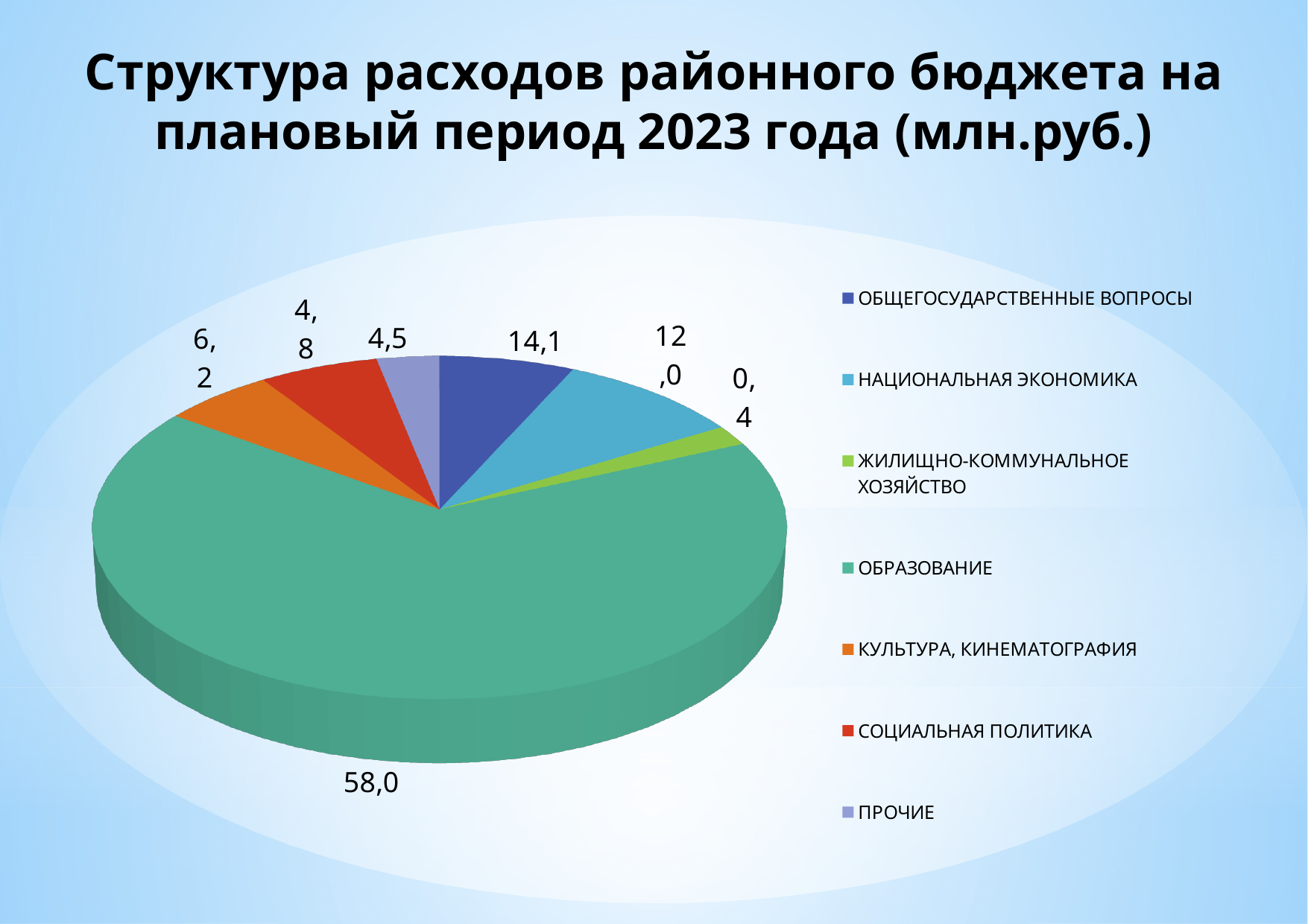
How many categories does the pie chart have? 7 Which is larger, the value for СОЦИАЛЬНАЯ ПОЛИТИКА or the value for ПРОЧИЕ? СОЦИАЛЬНАЯ ПОЛИТИКА Which category has the largest slice of the pie? ОБРАЗОВАНИЕ What is the value for КУЛЬТУРА, КИНЕМАТОГРАФИЯ? 6,2 What is the value for ЖИЛИЩНО-КОММУНАЛЬНОЕ ХОЗЯЙСТВО? 0,4 Which category has the smallest slice of the pie? ЖИЛИЩНО-КОММУНАЛЬНОЕ ХОЗЯЙСТВО What colour is the slice for НАЦИОНАЛЬНАЯ ЭКОНОМИКА? light blue What is the value for ОБРАЗОВАНИЕ? 58,0 What is the difference between the values for ОБЩЕГОСУДАРСТВЕННЫЕ ВОПРОСЫ and НАЦИОНАЛЬНАЯ ЭКОНОМИКА? 2,1 What kind of chart is shown on the slide? pie chart What is the value for ОБЩЕГОСУДАРСТВЕННЫЕ ВОПРОСЫ? 14,1